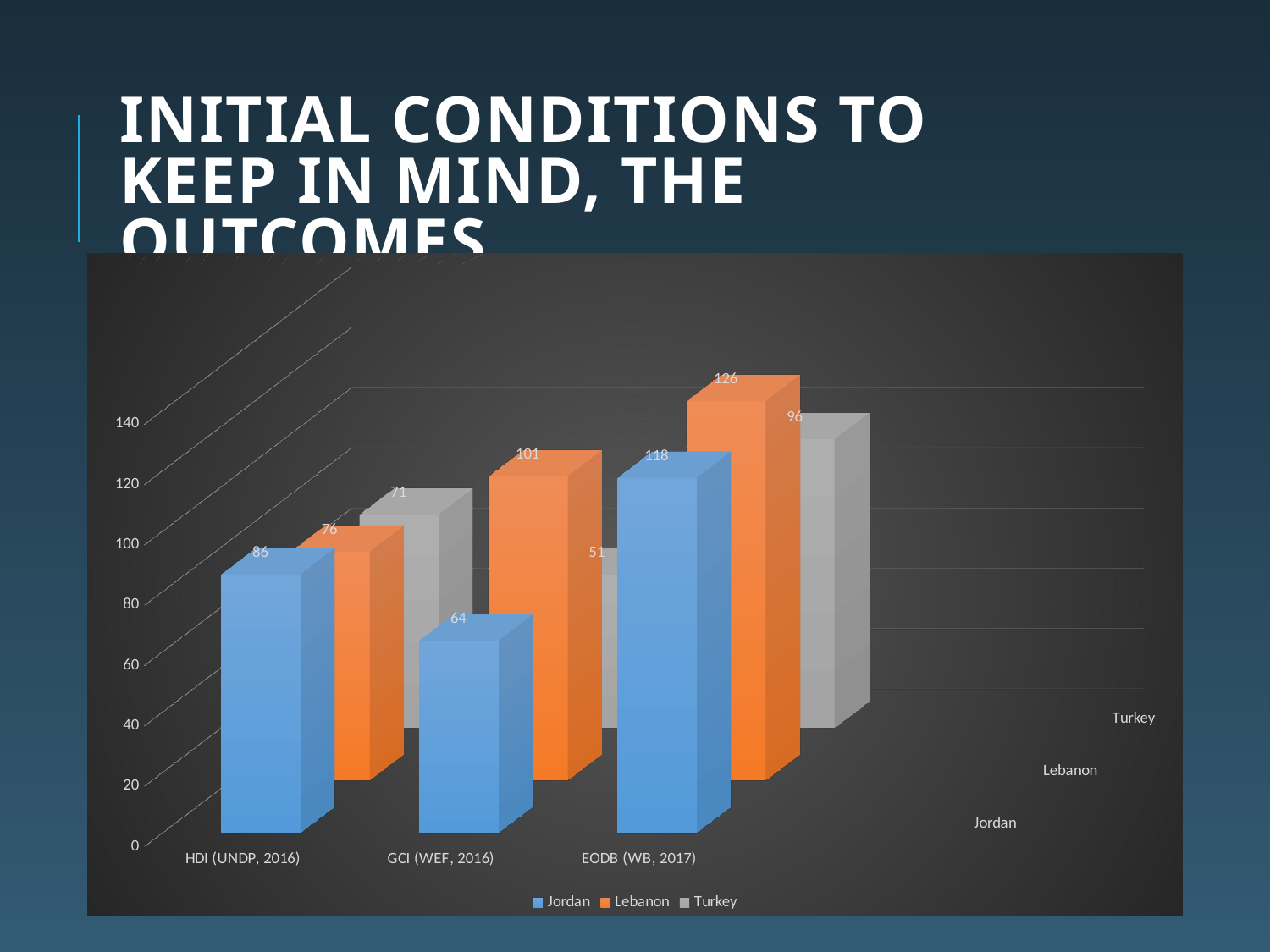
What is the value for Turkey in the EODB (WB, 2017) category? 96 What is the difference between Lebanon's and Jordan's values in the GCI (WEF, 2016) category? 37 What kind of chart is shown on the slide? Bar chart How many categories are shown on the x axis? 3 What is the value for Lebanon in the GCI (WEF, 2016) category? 101 Which country has the highest value in the EODB (WB, 2017) category? Lebanon Which country has the lowest value in the GCI (WEF, 2016) category? Turkey Which series is shown in orange? Lebanon How many series does the legend list? 3 What is the value for Jordan in the HDI (UNDP, 2016) category? 86 Which is larger: Jordan's value for HDI (UNDP, 2016) or Lebanon's value for HDI (UNDP, 2016)? Jordan's value for HDI (UNDP, 2016) What is the value for Jordan in the EODB (WB, 2017) category? 118